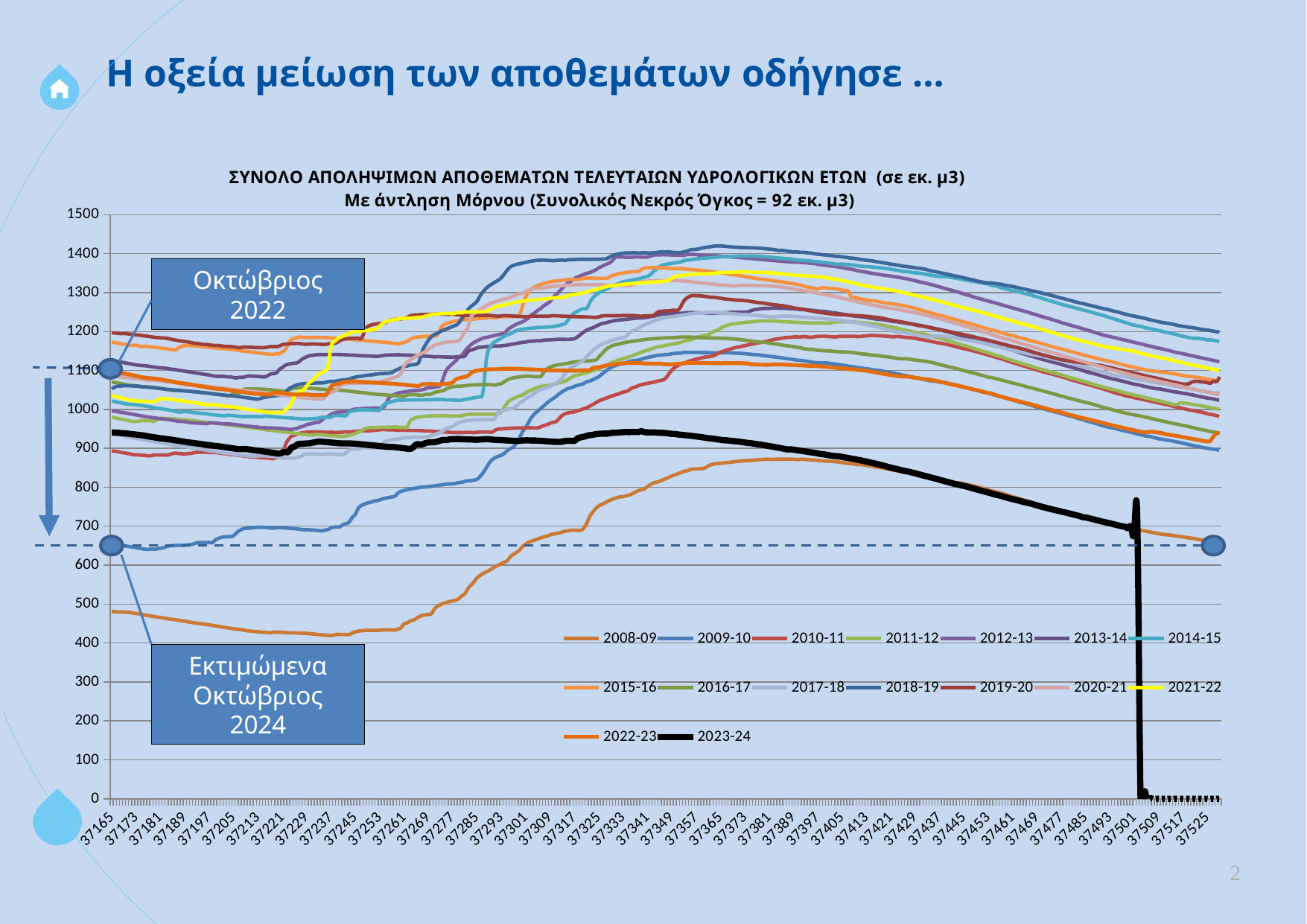
Which series is drawn as the thick black line? 2023-24 Is the starting value of the 2008-09 series greater or less than 500? less What kind of chart is shown on the slide? line chart Which series is drawn in yellow? 2021-22 Is the starting value of the 2023-24 series greater or less than 900? greater How many series does the chart legend list? 16 After its peak around 37341, does the 2023-24 series rise or fall toward 37501? fall Is the peak value of the 2018-19 series greater or less than 1300? greater What is the maximum value shown on the y axis? 1500 At the start of the x axis, which series has the larger value: 2008-09 or 2023-24? 2023-24 Which series has the lowest value at the start of the x axis (37165)? 2008-09